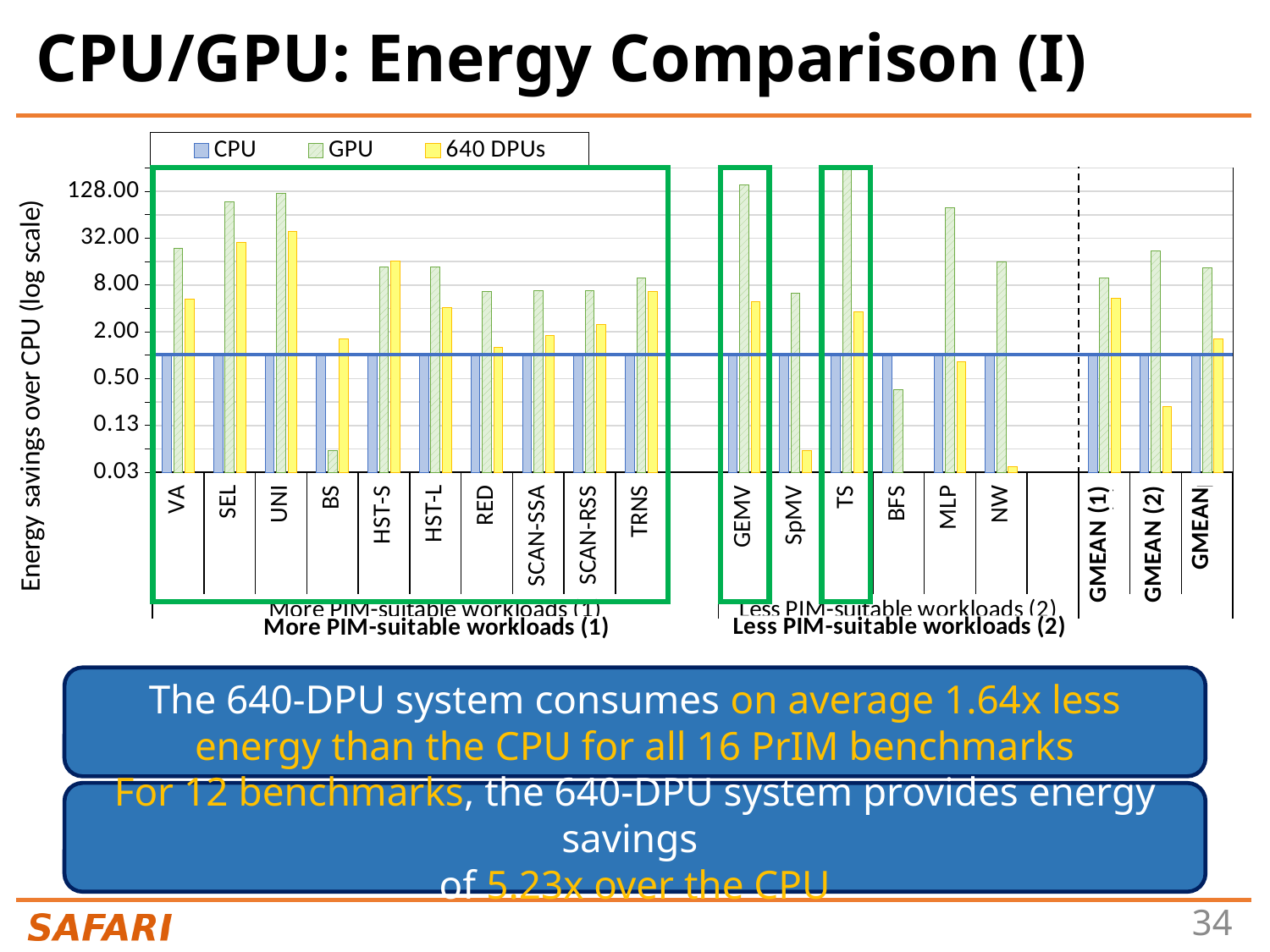
Is the GPU value for BS greater or less than 0.13? less For BS, which is larger: the GPU value or the 640 DPUs value? 640 DPUs Which series are listed in the chart legend? CPU, GPU, 640 DPUs Which category has the lowest GPU value? BS Is the 640 DPUs value for NW greater or less than 0.13? less Is the 640 DPUs value for UNI greater or less than 32.00? greater How many categories are shown along the x-axis of the chart? 19 What is the label of the y-axis? Energy savings over CPU (log scale) What kind of chart is shown on the slide? bar chart How many series does the chart legend list? 3 Which category has the highest 640 DPUs value? UNI